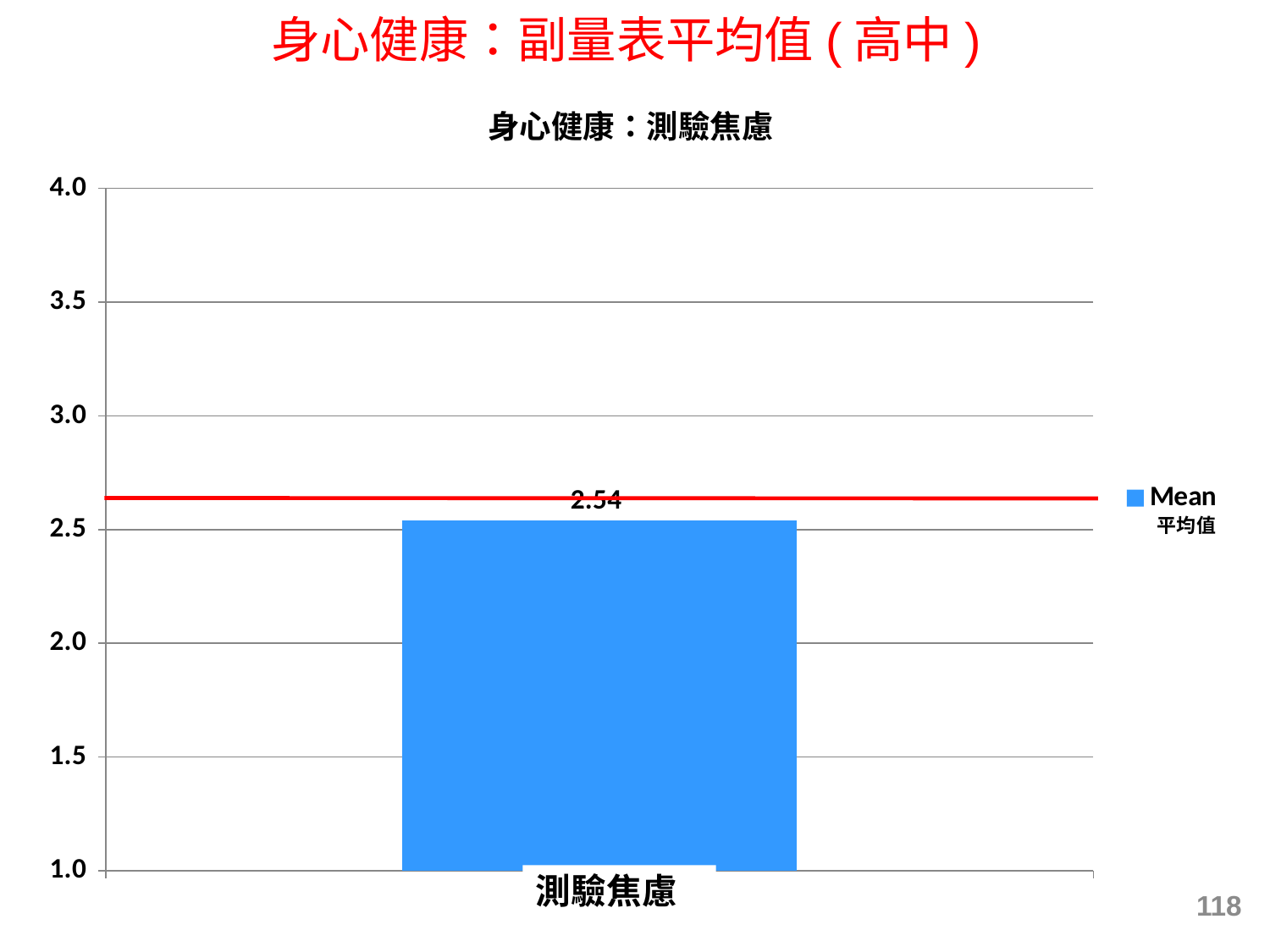
Is the value for 測驗焦慮 greater or less than 2.5? greater Is the value for 測驗焦慮 greater or less than 2.0? greater Does the top of the 測驗焦慮 bar lie above or below the red horizontal line? below What series name is shown in the legend? Mean 平均值 What kind of chart is shown on the slide? bar chart How many series does the legend list? 1 How many bars are plotted in the chart? 1 What is the highest value shown on the vertical axis? 4.0 Is the value for 測驗焦慮 greater or less than 3.0? less What is the value of the bar for 測驗焦慮? 2.54 What is the title of the chart? 身心健康：測驗焦慮